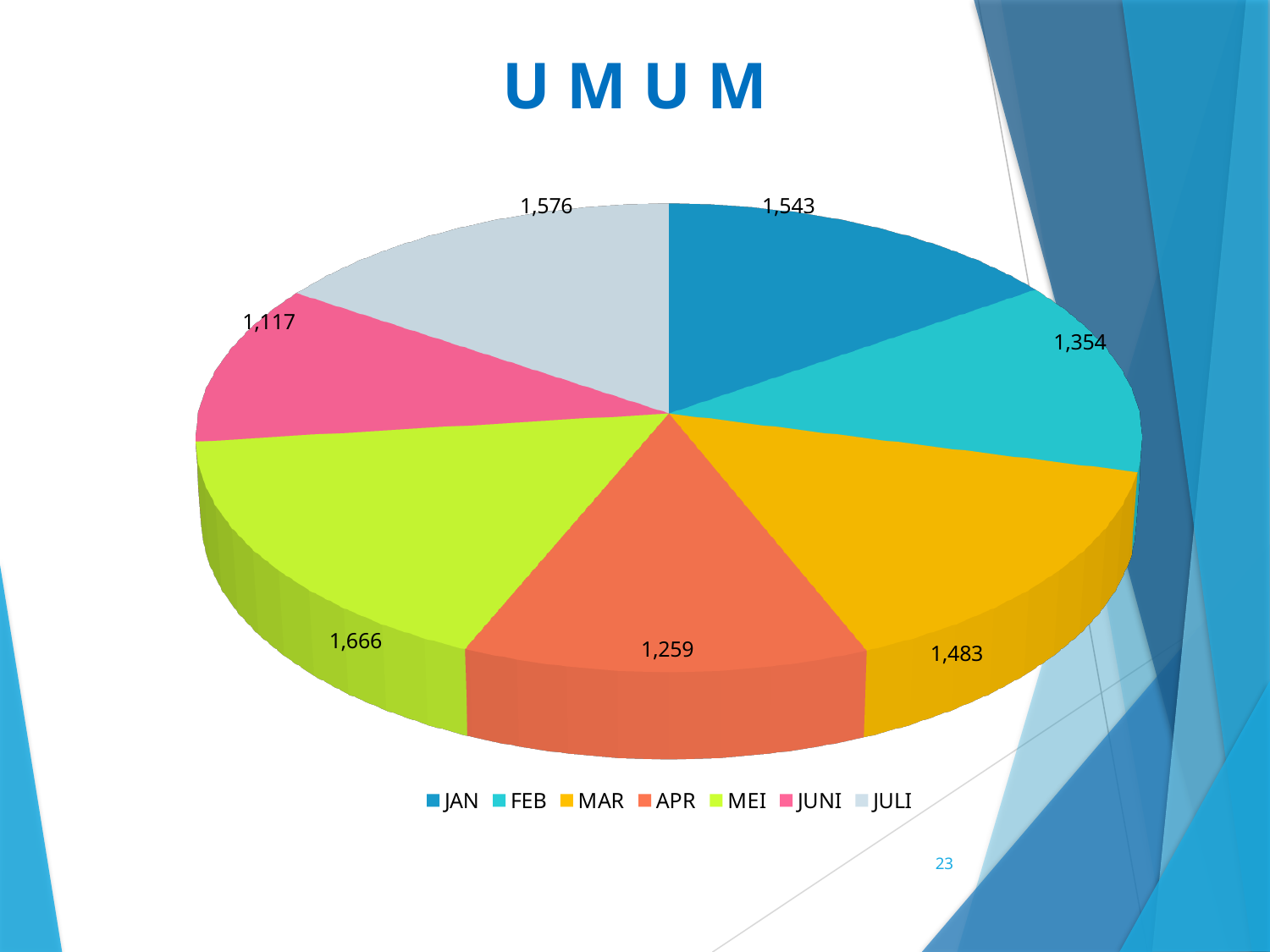
Which is larger, the value for JAN or the value for JULI? JULI What is the value for MEI? 1,666 What is the value for JAN? 1,543 How many entries does the legend list? 7 What is the title of the chart? UMUM What is the difference between the values for MEI and JUNI? 549 How many slices does the pie chart have? 7 Which month has the largest slice? MEI What is the value for APR? 1,259 What kind of chart is shown on the slide? pie chart Which month has the smallest slice? JUNI What is the difference between the values for MAR and FEB? 129